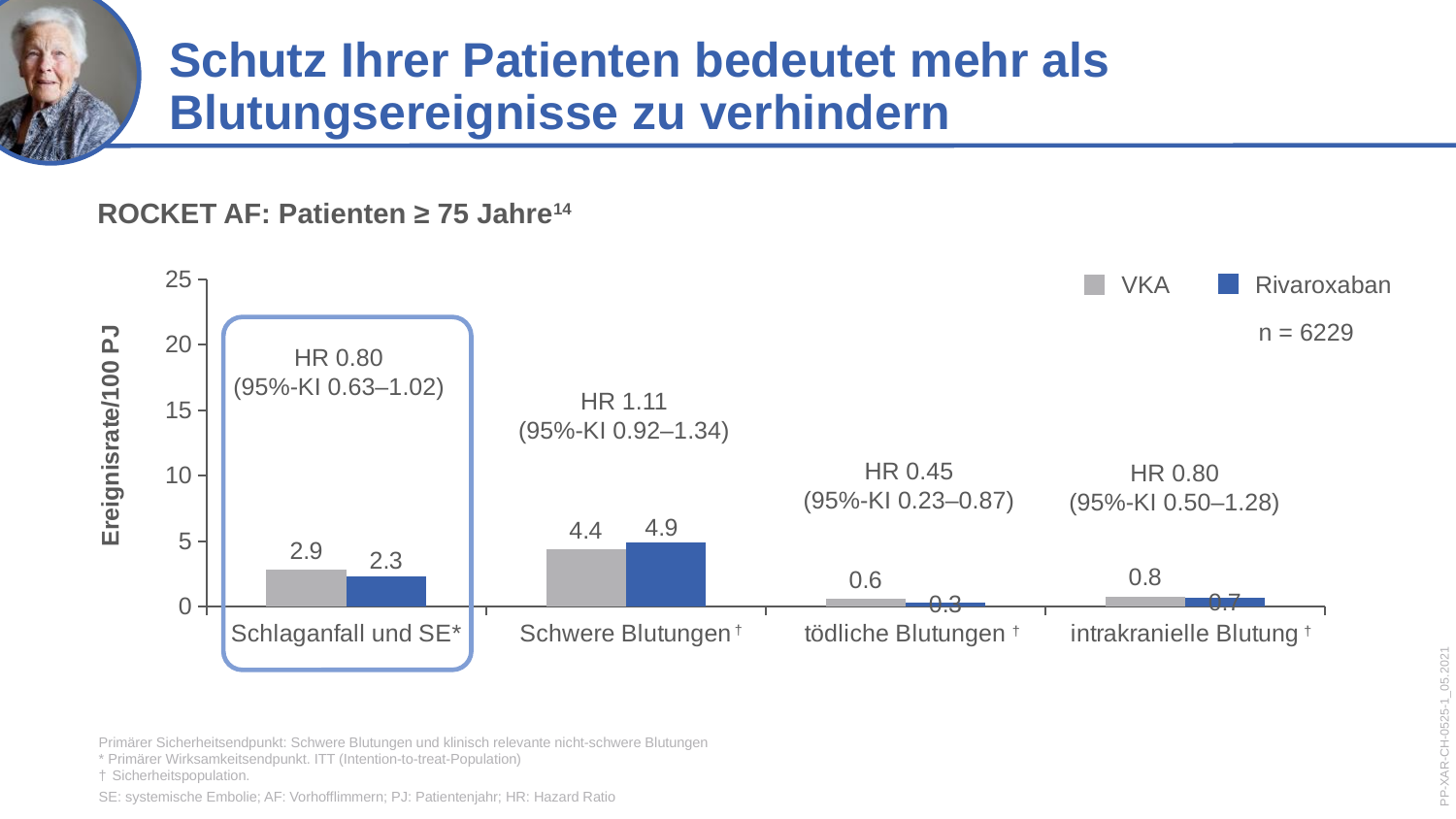
What is the difference between the VKA and Rivaroxaban event rates for 'Schlaganfall und SE*'? 0.6 In the 'Schwere Blutungen' category, which series has the larger event rate, VKA or Rivaroxaban? Rivaroxaban How many categories are shown on the x axis? 4 What is the event rate for VKA in the 'Schlaganfall und SE*' category? 2.9 What is the event rate for VKA in the 'tödliche Blutungen' category? 0.6 What is the event rate for Rivaroxaban in the 'Schlaganfall und SE*' category? 2.3 Which category has the highest VKA event rate? Schwere Blutungen What is the event rate for VKA in the 'Schwere Blutungen' category? 4.4 What kind of chart is shown on the slide? bar chart What is the event rate for Rivaroxaban in the 'Schwere Blutungen' category? 4.9 Is the Rivaroxaban event rate for 'Schwere Blutungen' greater or less than 10? less How many series does the legend list? 2